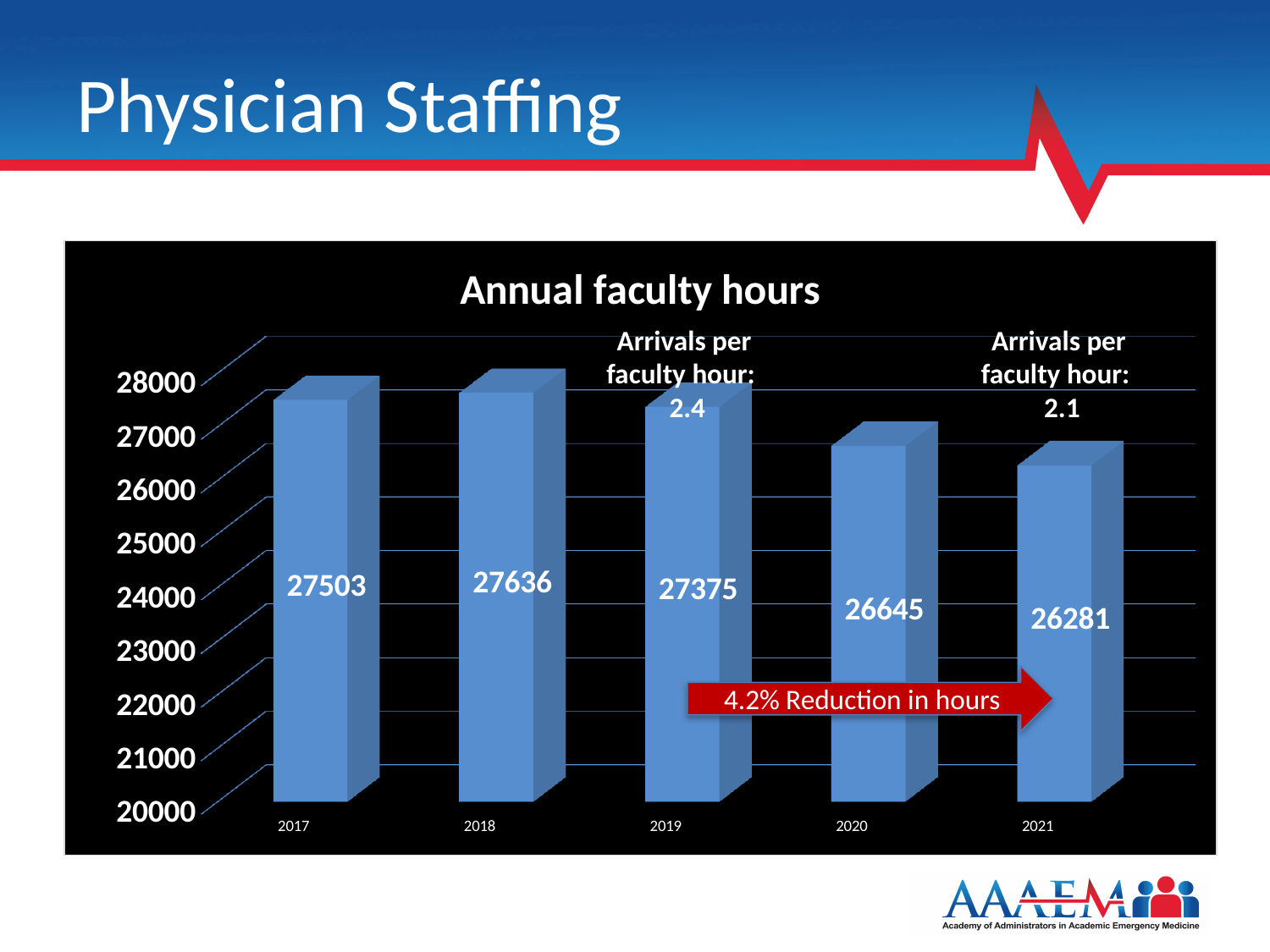
What is the value for 2019 in the Annual faculty hours chart? 27375 Which year has the lowest annual faculty hours? 2021 Which year has more annual faculty hours, 2017 or 2020? 2017 How many years are shown in the Annual faculty hours chart? 5 Which year has the highest annual faculty hours? 2018 Is the value for 2020 greater or less than 27000? less What is the value for 2021 in the Annual faculty hours chart? 26281 What is the difference in annual faculty hours between 2019 and 2020? 730 What kind of chart is shown on the slide? bar chart What is the value for 2017 in the Annual faculty hours chart? 27503 What is the difference in annual faculty hours between 2018 and 2021? 1355 What is the title of the chart on the slide? Annual faculty hours